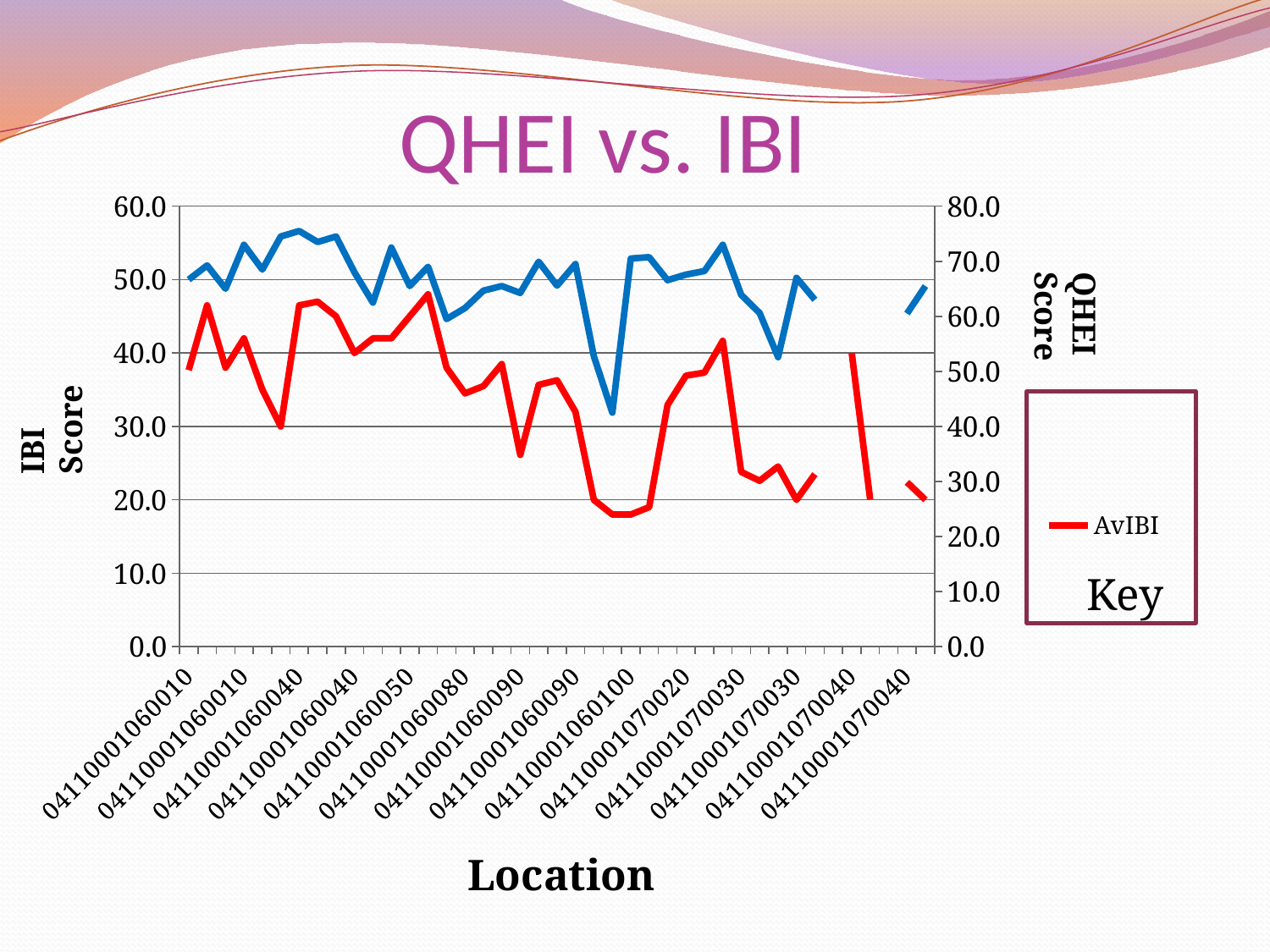
What is the title of the x axis of the chart? Location Which series is listed in the chart's legend (Key)? AvIBI Overall, do the AvIBI values rise or fall from the left of the x axis to the right? fall Is the highest value of the AvIBI series greater or less than 50.0 on the IBI Score axis? less What is the maximum value shown on the right (QHEI Score) axis? 80.0 What is the title of the chart? QHEI vs. IBI Is the highest value of the blue QHEI series greater or less than 70.0 on the QHEI Score axis? greater Is the lowest value of the AvIBI series greater or less than 20.0 on the IBI Score axis? less What kind of chart is shown on the slide? line chart